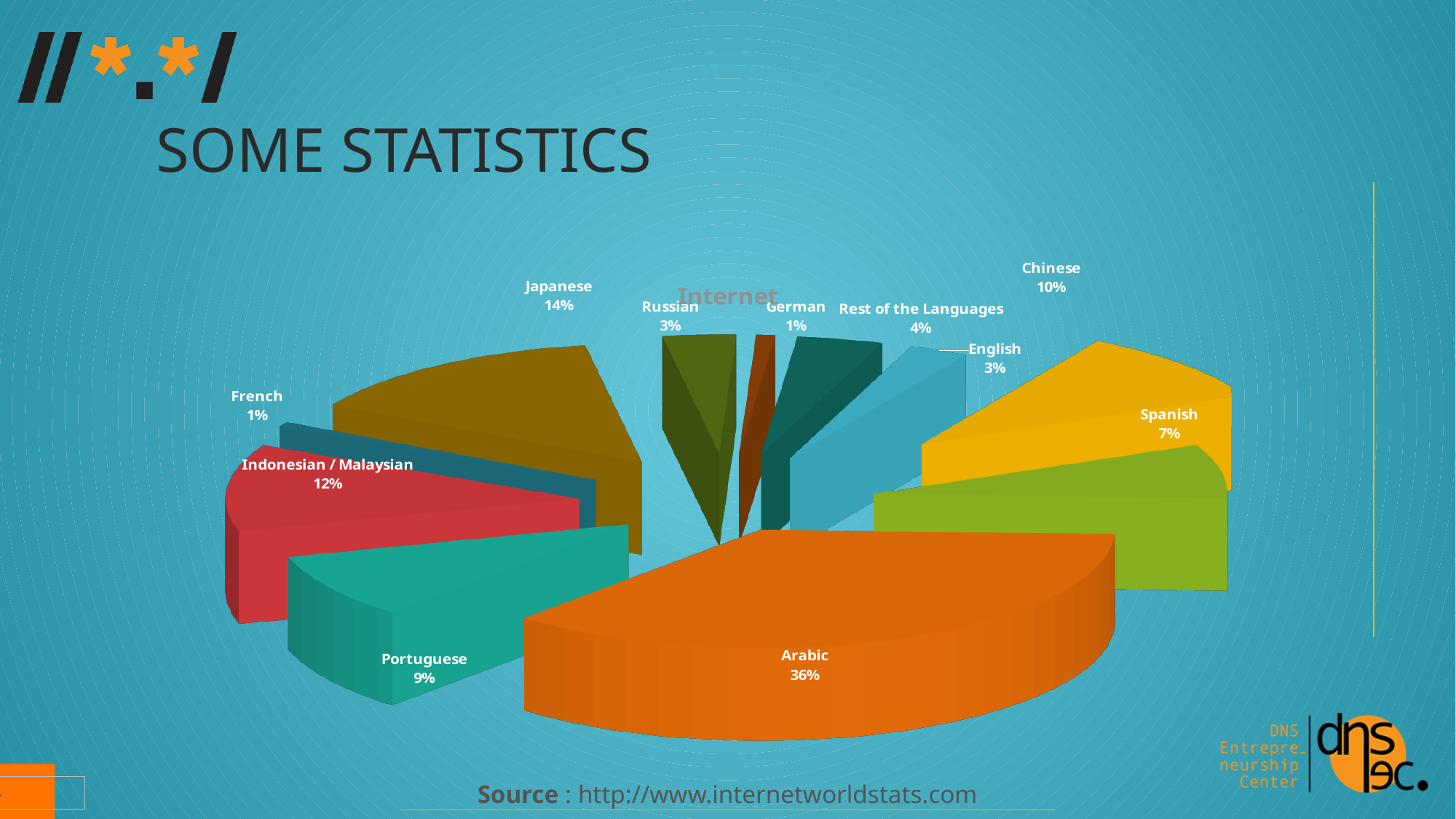
What is the difference between the Chinese share and the Spanish share? 3% Which language has the largest share of the pie? Arabic What percentage is shown for Rest of the Languages? 4% Which is larger, the share for Japanese or the share for Chinese? Japanese How many language categories are labelled on the pie chart? 11 What source is cited for the chart data? http://www.internetworldstats.com What percentage is shown for Indonesian / Malaysian? 12% What share of the pie does Arabic have? 36% What is the title of the pie chart? Internet What is the difference between the Arabic share and the Japanese share? 22% What kind of chart is shown on the slide? pie chart What percentage is shown for Japanese? 14%